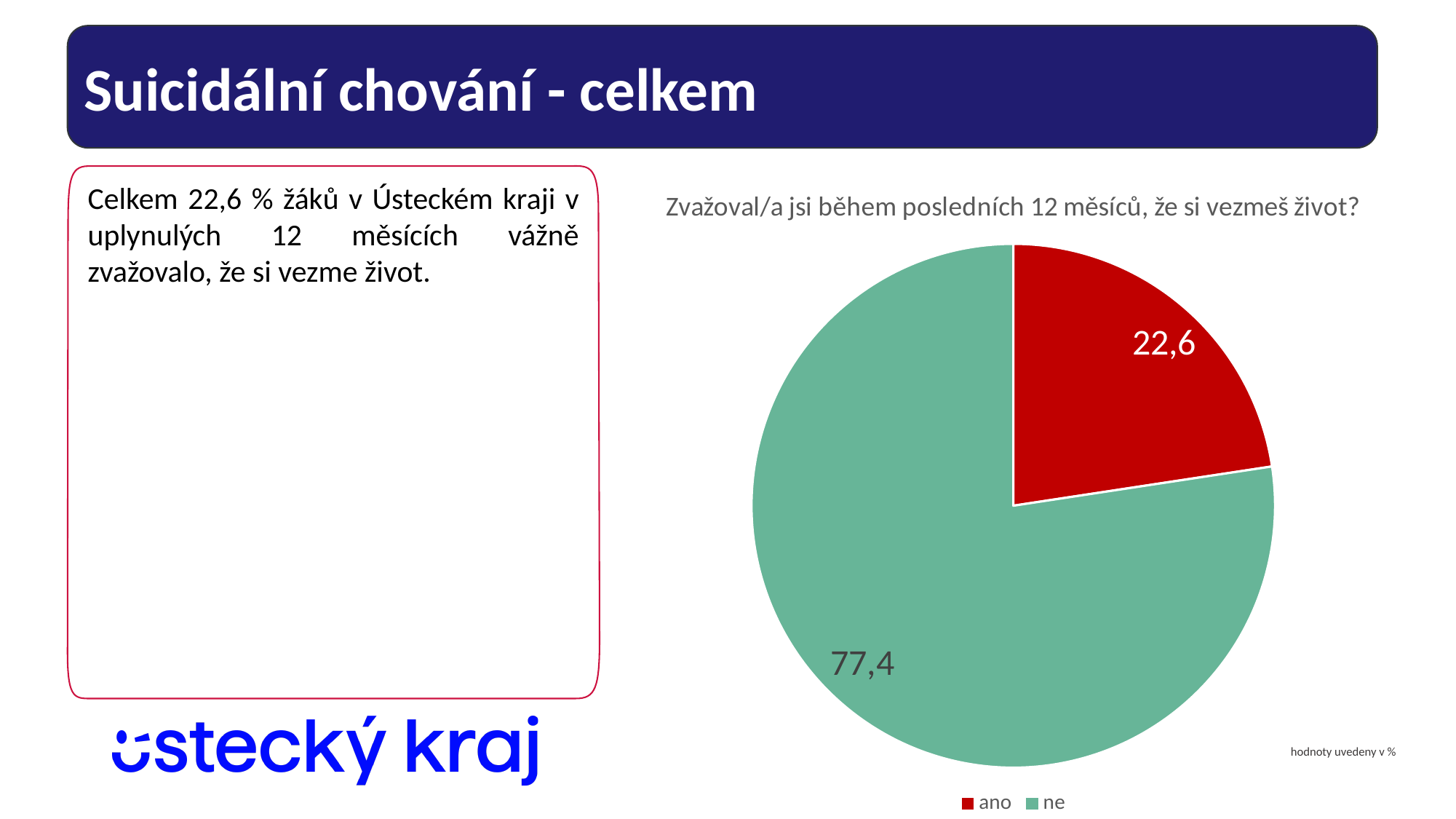
Which is larger, the value for "ano" or the value for "ne"? ne What is the difference between the values for "ne" and "ano"? 54,8 Which category has the largest slice in the pie chart? ne What is the value for "ne" in the pie chart? 77,4 What colour is the "ano" slice in the pie chart? red What is the value for "ano" in the pie chart? 22,6 What share of the pie does the "ne" slice represent? 77,4 % Which category has the smallest slice in the pie chart? ano How many slices does the pie chart have? 2 What kind of chart is shown on the slide? pie chart What is the title of the pie chart? Zvažoval/a jsi během posledních 12 měsíců, že si vezmeš život? How many entries does the legend list? 2